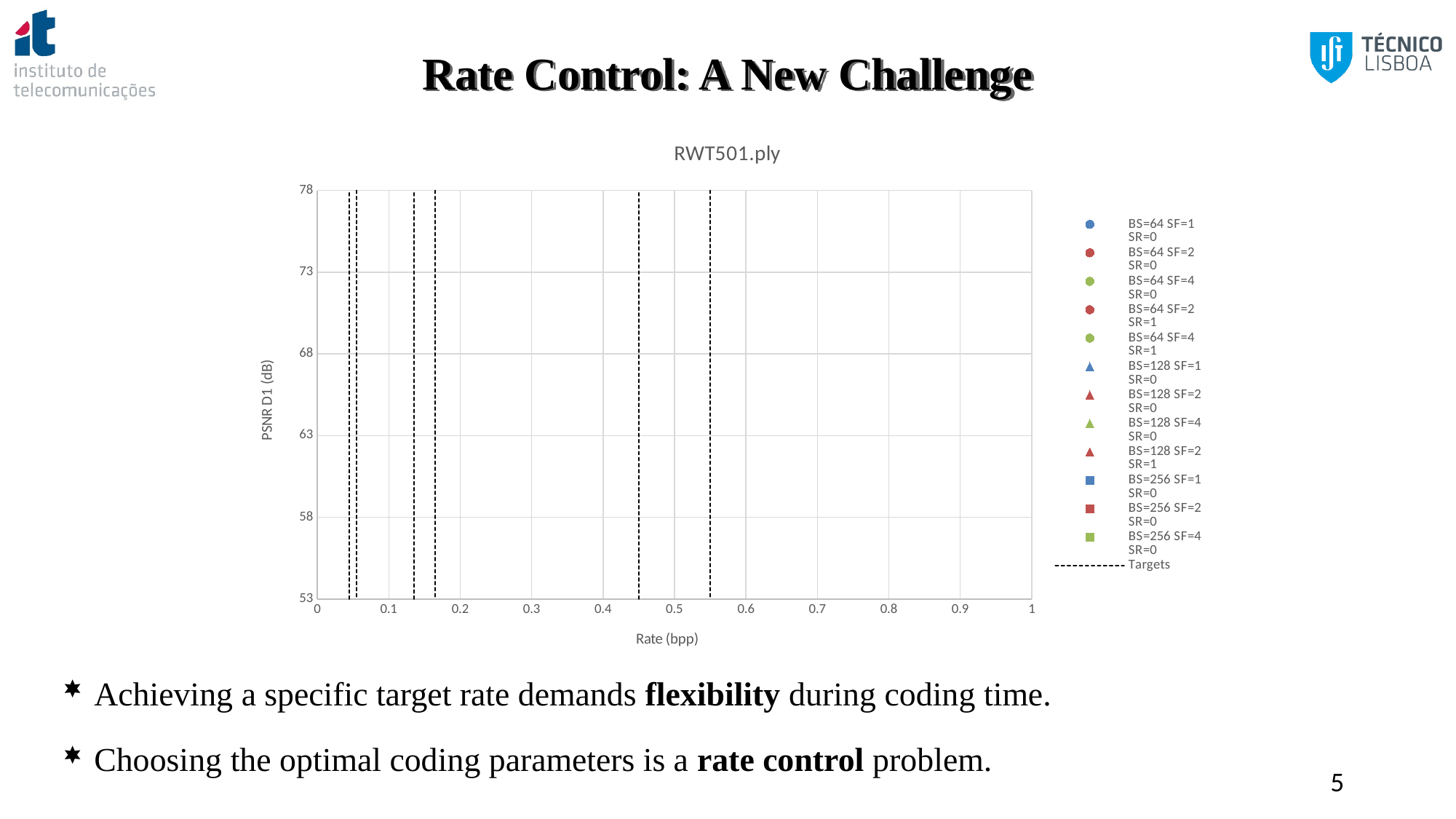
What kind of chart is shown on the slide? scatter chart How many dashed 'Targets' lines are drawn on the chart? 6 What is the label of the y axis? PSNR D1 (dB) What is the title of the chart? RWT501.ply Are the dashed target lines on the chart vertical or horizontal? vertical How many entries does the chart's legend list? 13 Is the rate value of the rightmost dashed target line greater or less than 0.5? greater Is the rate value of the leftmost dashed target line greater or less than 0.1? less